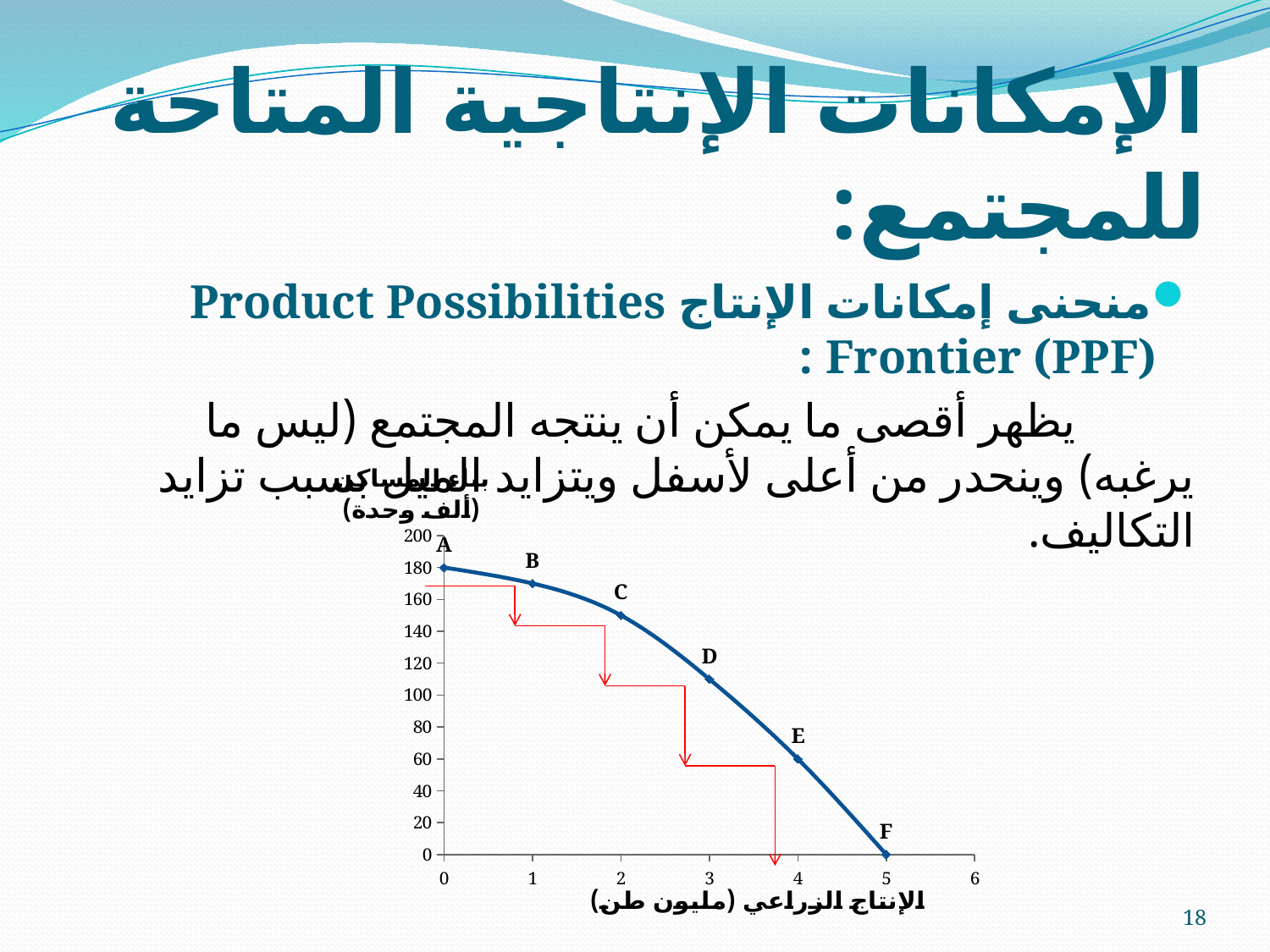
Which labeled point has the highest y-axis value? A Do the values on the curve rise or fall as the x-axis value increases? fall What is the y-axis value at point F? 0 Which labeled point has the lowest y-axis value? F Is the y-axis value at point D greater or less than 120? less What is the y-axis value at point A? 180 What is the y-axis value at point E? 60 What is the x-axis value at point D? 3 Is the y-axis value at point B greater or less than 160? greater What is the difference between the y-axis values at point A and point E? 120 How many labeled points are plotted on the curve? 6 What kind of chart is shown on the slide? line chart